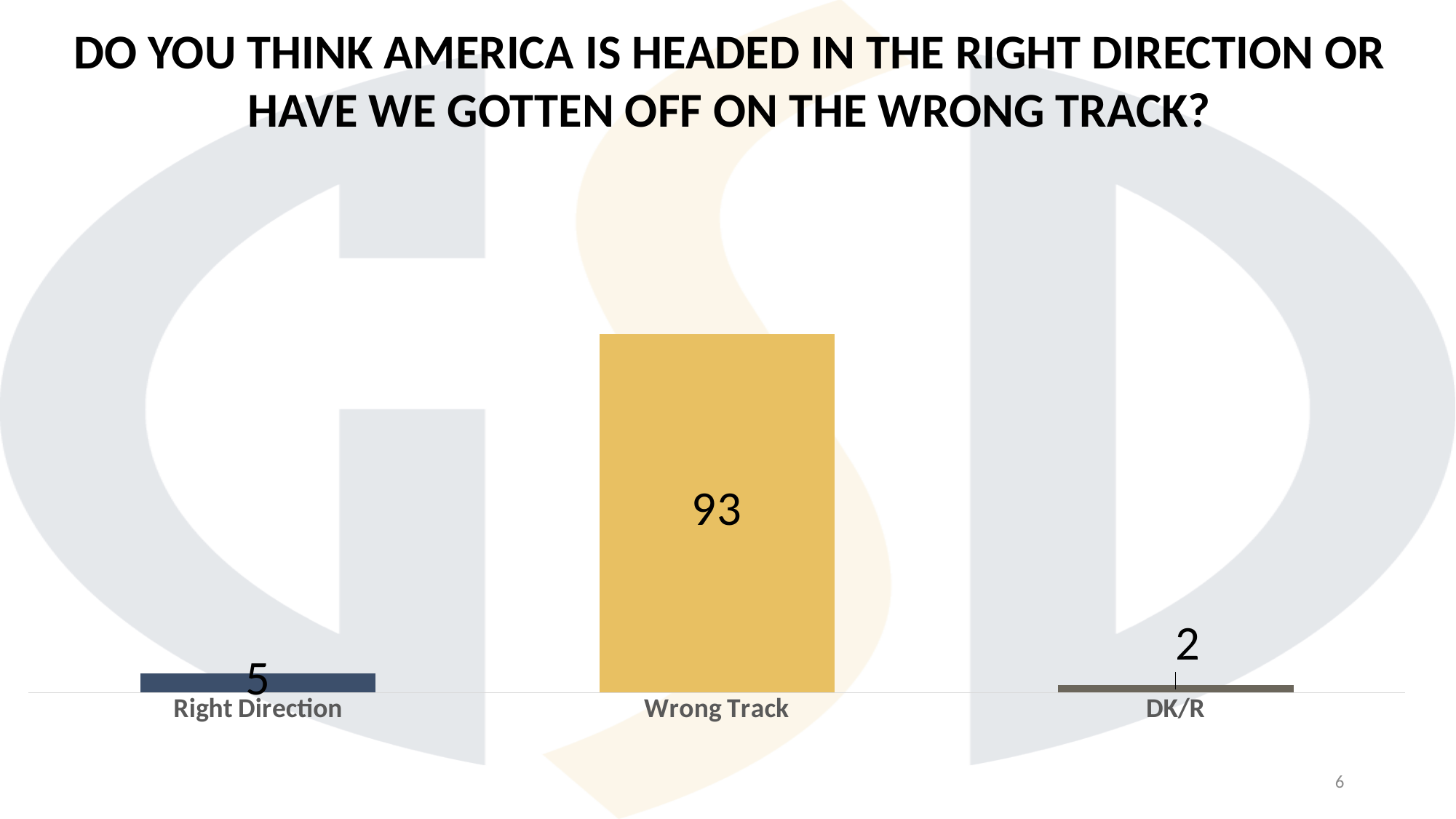
Which is larger, the value for Right Direction or the value for DK/R? Right Direction How many categories are shown in the chart? 3 What kind of chart is shown on the slide? bar chart What is the value for Right Direction? 5 What is the difference between the values for Wrong Track and Right Direction? 88 What is the value for Wrong Track? 93 Which category has the lowest value? DK/R What is the total of the three values shown in the chart? 100 Which category has the highest value? Wrong Track What colour is the Wrong Track bar? yellow What is the value for DK/R? 2 What is the difference between the values for Right Direction and DK/R? 3